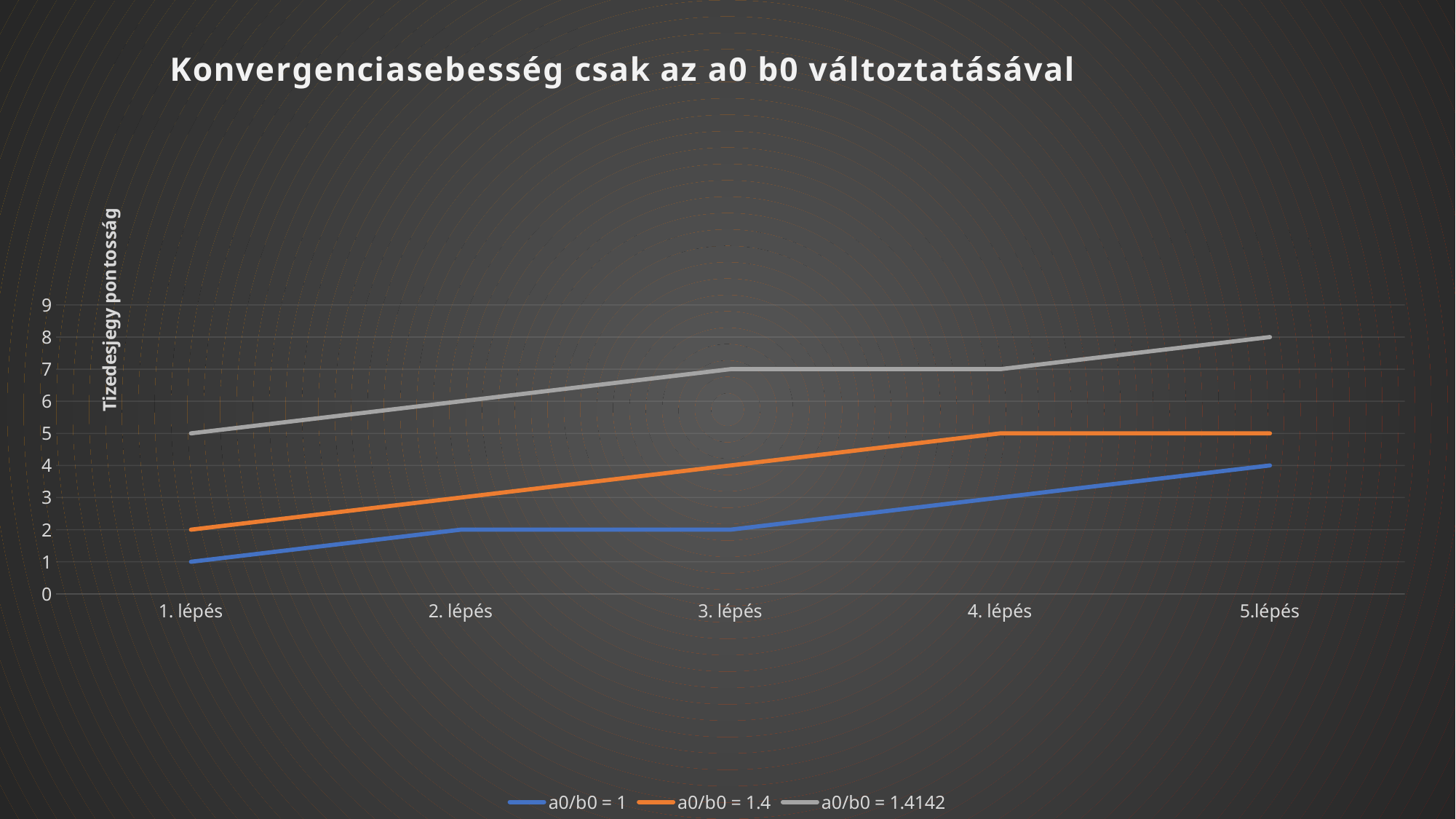
What is the value for a0/b0 = 1.4 at 3. lépés? 4 Which series has the highest value at 5.lépés? a0/b0 = 1.4142 At 4. lépés, which is larger: a0/b0 = 1.4 or a0/b0 = 1? a0/b0 = 1.4 Which series has the lowest value at 1. lépés? a0/b0 = 1 What is the value for a0/b0 = 1 at 5.lépés? 4 What is the title of the chart? Konvergenciasebesség csak az a0 b0 változtatásával What is the difference between a0/b0 = 1.4142 and a0/b0 = 1 at 5.lépés? 4 What is the value for a0/b0 = 1.4142 at 1. lépés? 5 Does the a0/b0 = 1.4142 series rise or fall from 1. lépés to 5.lépés? rise What kind of chart is shown on the slide? line chart How many series does the legend list? 3 How many steps (categories) are shown on the x axis? 5